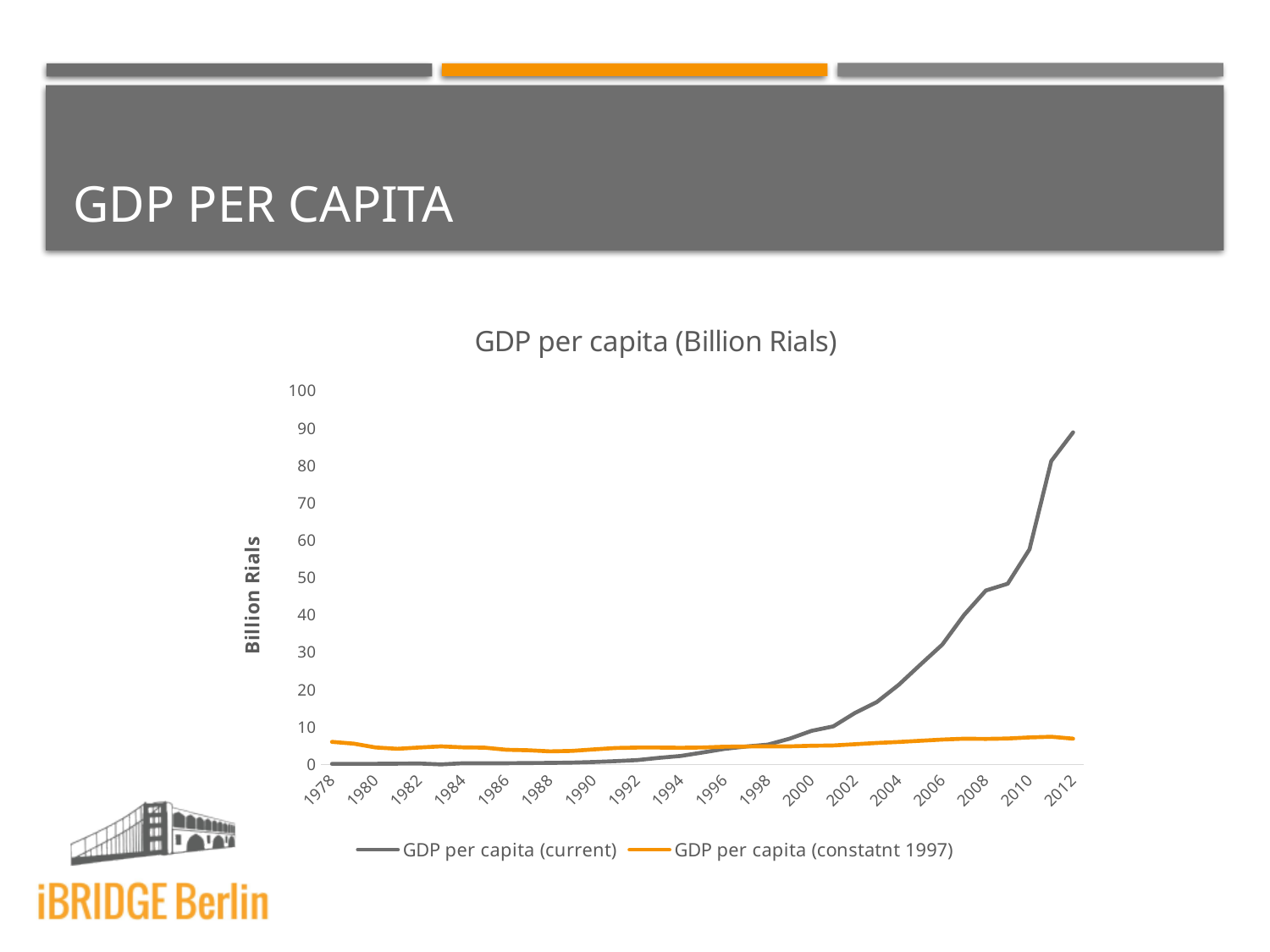
Is the value for GDP per capita (current) in 2008 greater or less than 40? greater Is the value for GDP per capita (constatnt 1997) in 2012 greater or less than 10? less In 1980, which series has the larger value: GDP per capita (current) or GDP per capita (constatnt 1997)? GDP per capita (constatnt 1997) What is the title of the chart? GDP per capita (Billion Rials) Is the value for GDP per capita (current) in 2000 greater or less than 20? less In which year does the GDP per capita (current) series reach its highest value? 2012 How many series does the legend list? 2 What kind of chart is shown on the slide? line chart In 2012, which series has the larger value: GDP per capita (current) or GDP per capita (constatnt 1997)? GDP per capita (current) What is the label on the vertical axis? Billion Rials Does the GDP per capita (current) series rise or fall from 1978 to 2012? rise